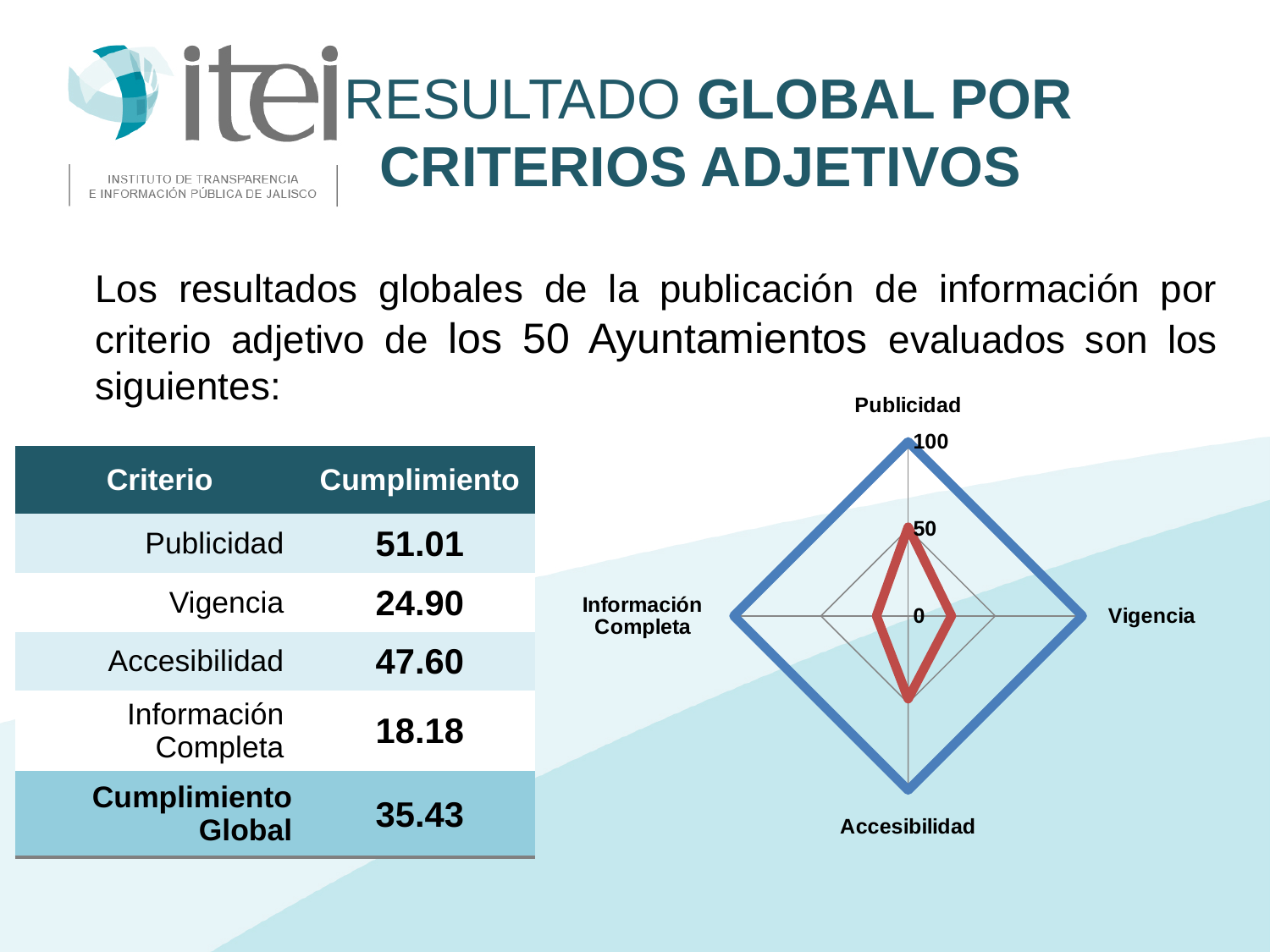
What is the difference between the Publicidad value and the Información Completa value? 32.83 Which is larger, the value for Vigencia or the value for Información Completa? Vigencia What is the Cumplimiento value for Información Completa? 18.18 Is the value for Vigencia on the radar chart greater or less than 50? less What is the Cumplimiento value for Publicidad? 51.01 What is the highest value shown on the radar chart's axis scale? 100 Which category has the lowest Cumplimiento value on the radar chart? Información Completa How many axes (categories) does the radar chart have? 4 Which category has the highest Cumplimiento value on the radar chart? Publicidad What is the Cumplimiento value for Vigencia? 24.90 What kind of chart is shown on the right of the slide? radar chart Is the value for Información Completa on the radar chart greater or less than 50? less